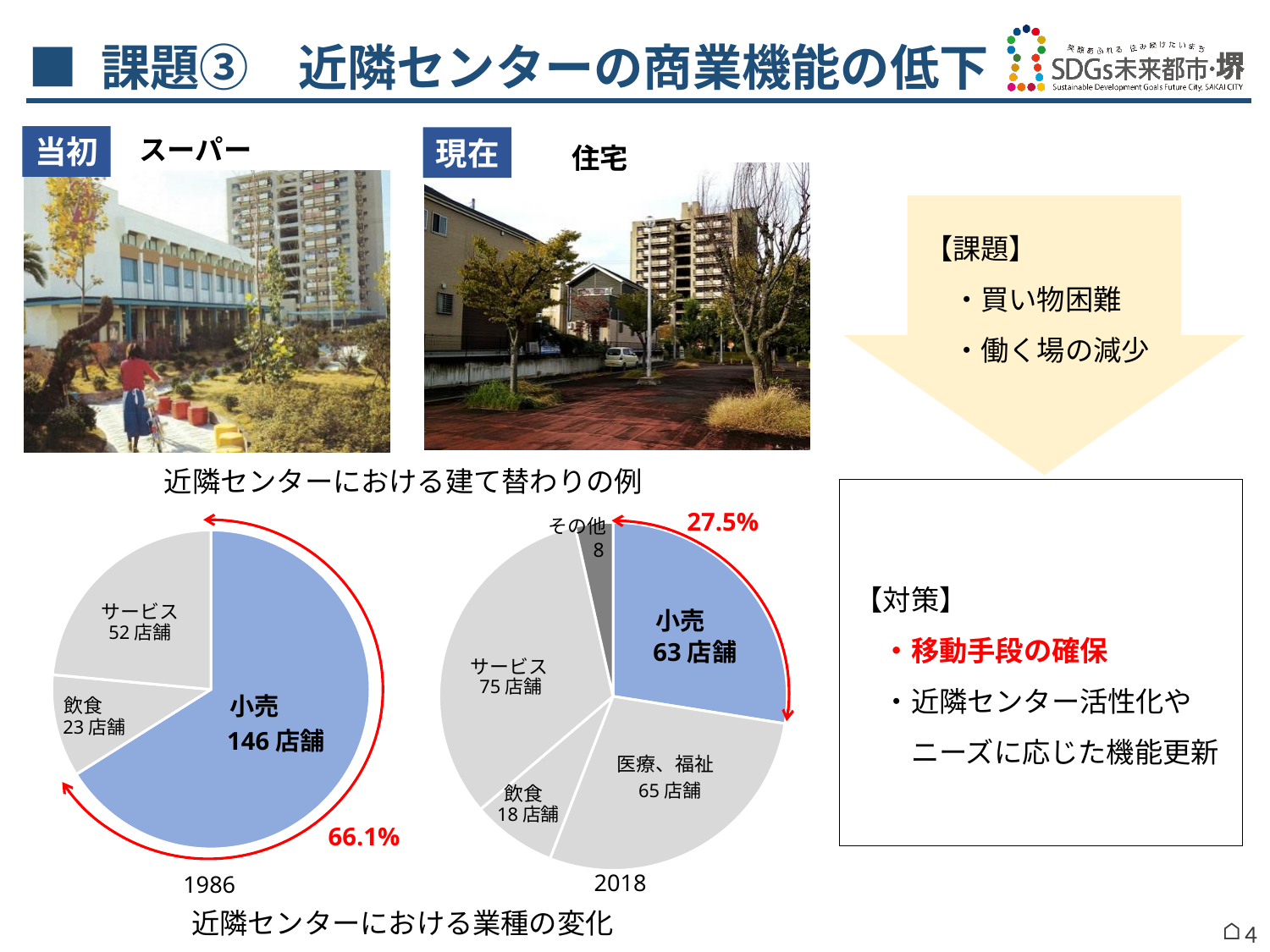
What type of chart is used to show 近隣センターにおける業種の変化? Pie chart In the 2018 pie chart, how many stores are in the サービス category? 75 店舗 In the 2018 pie chart, which is larger: サービス or 医療、福祉? サービス In the 2018 pie chart, which category has the smallest number of stores? その他 What share of the 2018 pie chart does the 小売 slice represent, as labelled on the slide? 27.5% In the 1986 pie chart, which category has the smallest number of stores? 飲食 In the 2018 pie chart, how many stores are in the 医療、福祉 category? 65 店舗 How many categories are shown in the 1986 pie chart? 3 In the 1986 pie chart, how many stores are in the 小売 category? 146 店舗 How many categories are shown in the 2018 pie chart? 5 What is the difference in the number of 小売 stores between the 1986 and 2018 pie charts? 83 店舗 In the 1986 pie chart, which category has the largest number of stores? 小売